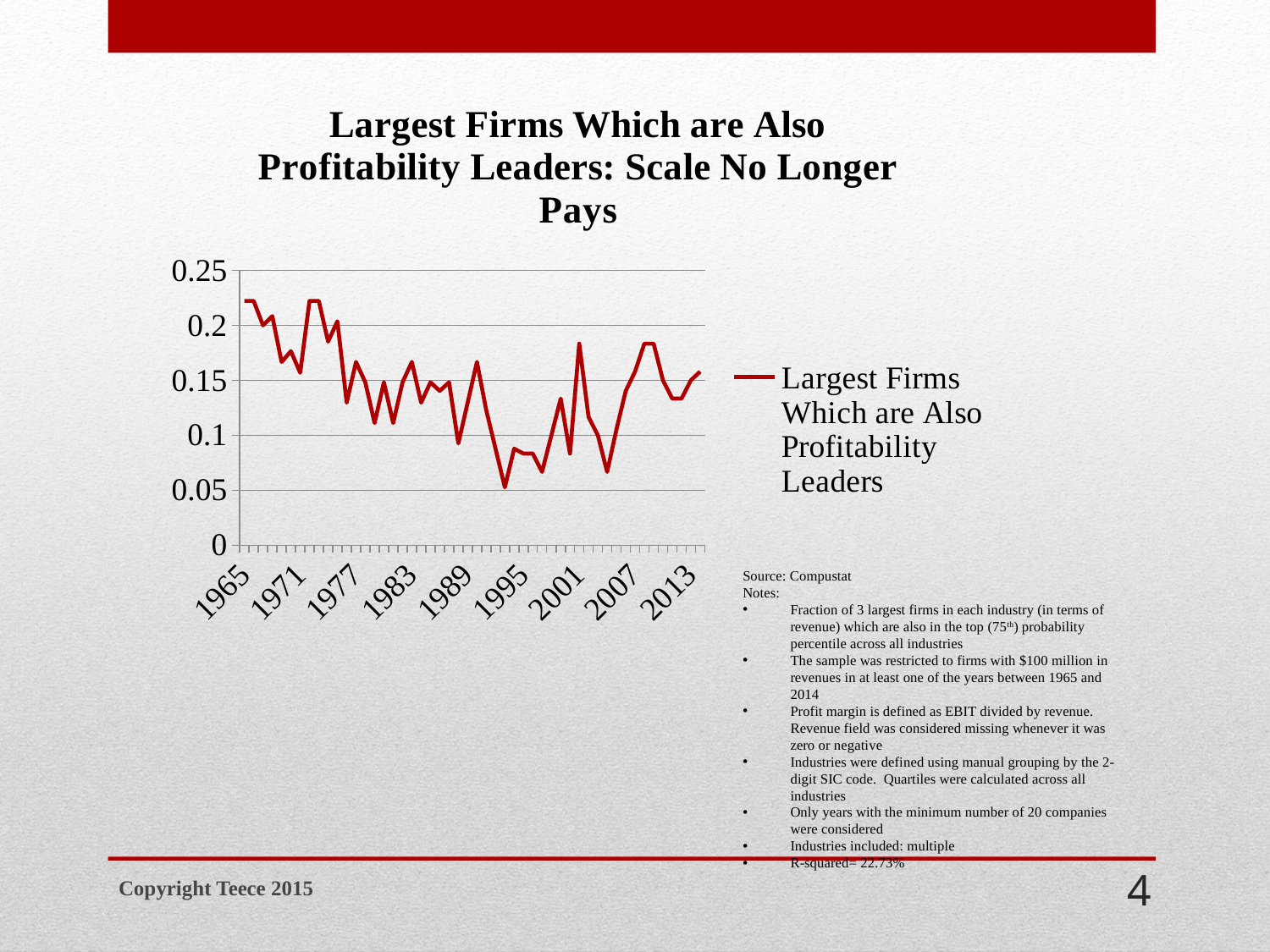
Is the value for 1977 greater or less than 0.2? less Overall, does the line rise or fall from 1965 to 2013? fall Is the value for 2013 greater or less than 0.2? less What is the name of the series shown in the legend? Largest Firms Which are Also Profitability Leaders Is the value for 1965 greater or less than 0.2? greater What kind of chart is shown on the slide? line chart What is the title of the chart on the slide? Largest Firms Which are Also Profitability Leaders: Scale No Longer Pays How many series does the legend list? 1 How many year labels are shown on the x axis? 9 What is the highest value shown on the y axis? 0.25